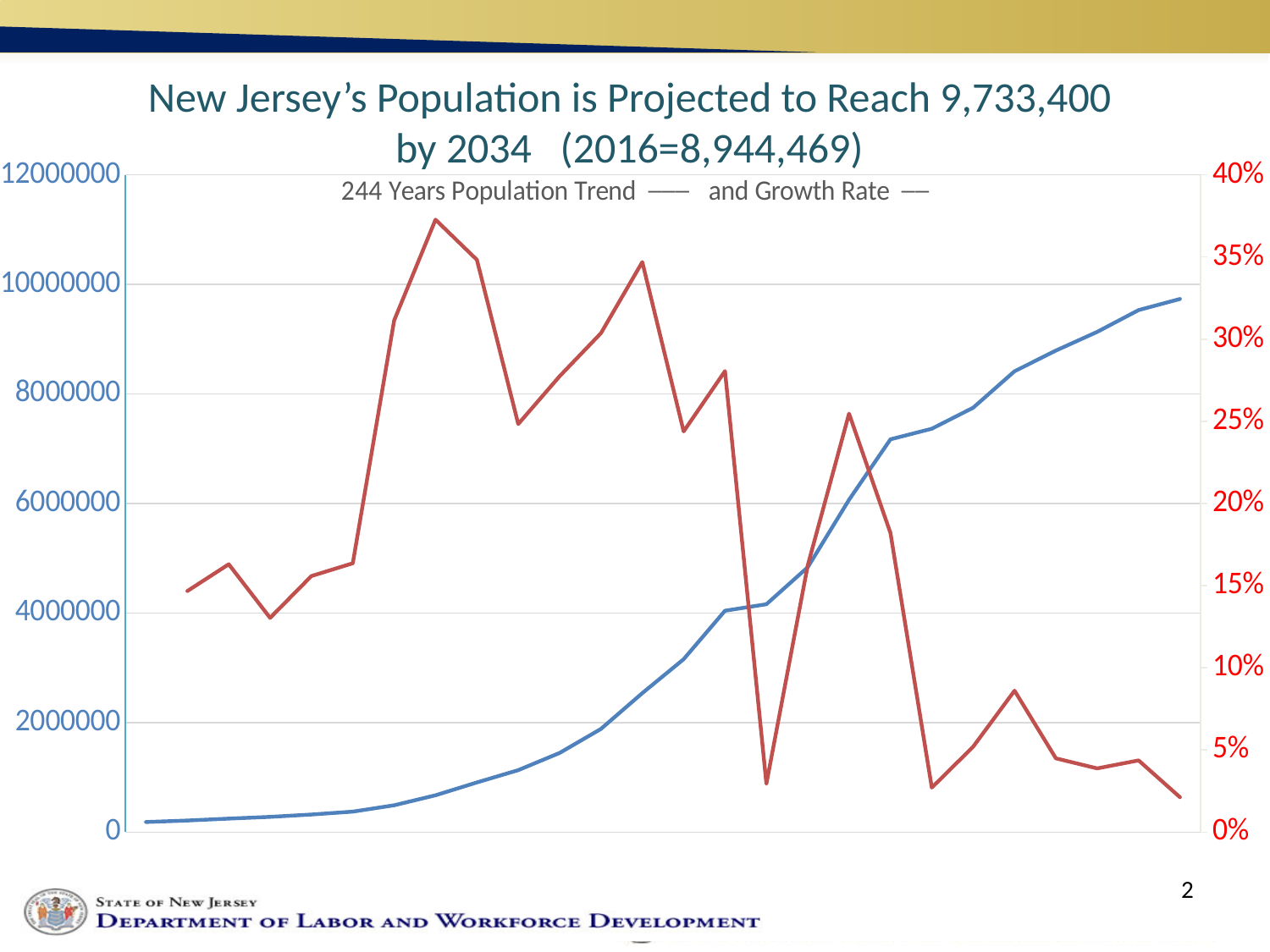
What kind of chart is shown on the slide? line chart Is the final value of the population line greater or less than 8000000? greater Is the final value of the growth rate line greater or less than 5%? less What is the maximum value shown on the left vertical axis? 12000000 According to the slide title, what population is New Jersey projected to reach by 2034? 9,733,400 Does the population line rise or fall along the x axis overall? rise What is the maximum value shown on the right vertical axis? 40% Which colour is the population trend line drawn in? blue Is the first value of the population line greater or less than 2000000? less How many series does the chart plot? 2 What is the title of the chart? 244 Years Population Trend and Growth Rate